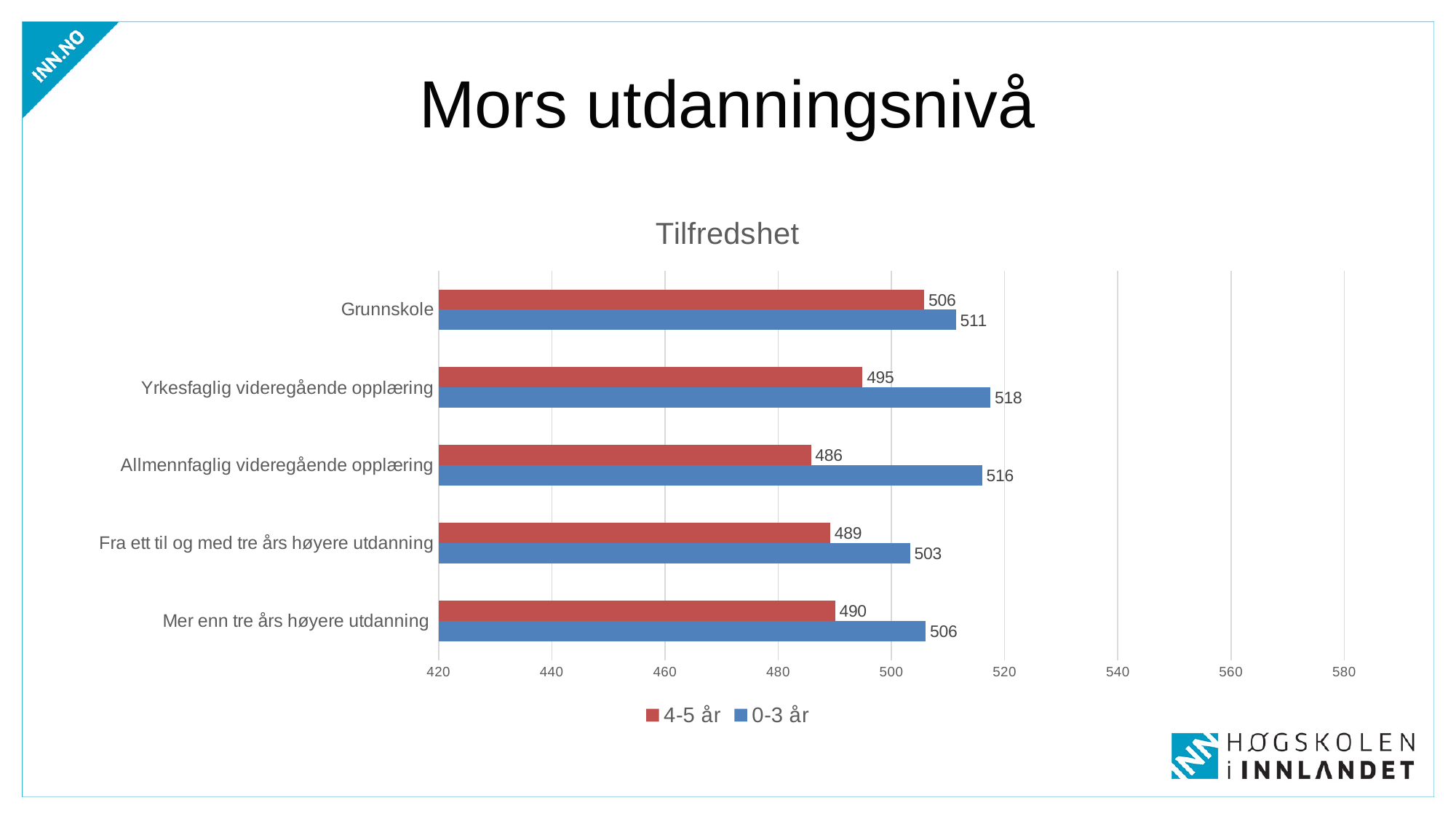
How many categories are shown on the chart? 5 What is the value for 0-3 år for Grunnskole? 511 Which is larger for Mer enn tre års høyere utdanning: the 4-5 år value or the 0-3 år value? 0-3 år What is the difference between the 0-3 år and 4-5 år values for Yrkesfaglig videregående opplæring? 23 Is the 4-5 år value for Grunnskole greater or less than 500? greater What is the value for 4-5 år for Allmennfaglig videregående opplæring? 486 How many series does the legend list? 2 Which category has the lowest value for 4-5 år? Allmennfaglig videregående opplæring What is the value for 0-3 år for Fra ett til og med tre års høyere utdanning? 503 Which category has the highest value for 0-3 år? Yrkesfaglig videregående opplæring What kind of chart is shown on the slide? Bar chart What is the title of the chart? Tilfredshet